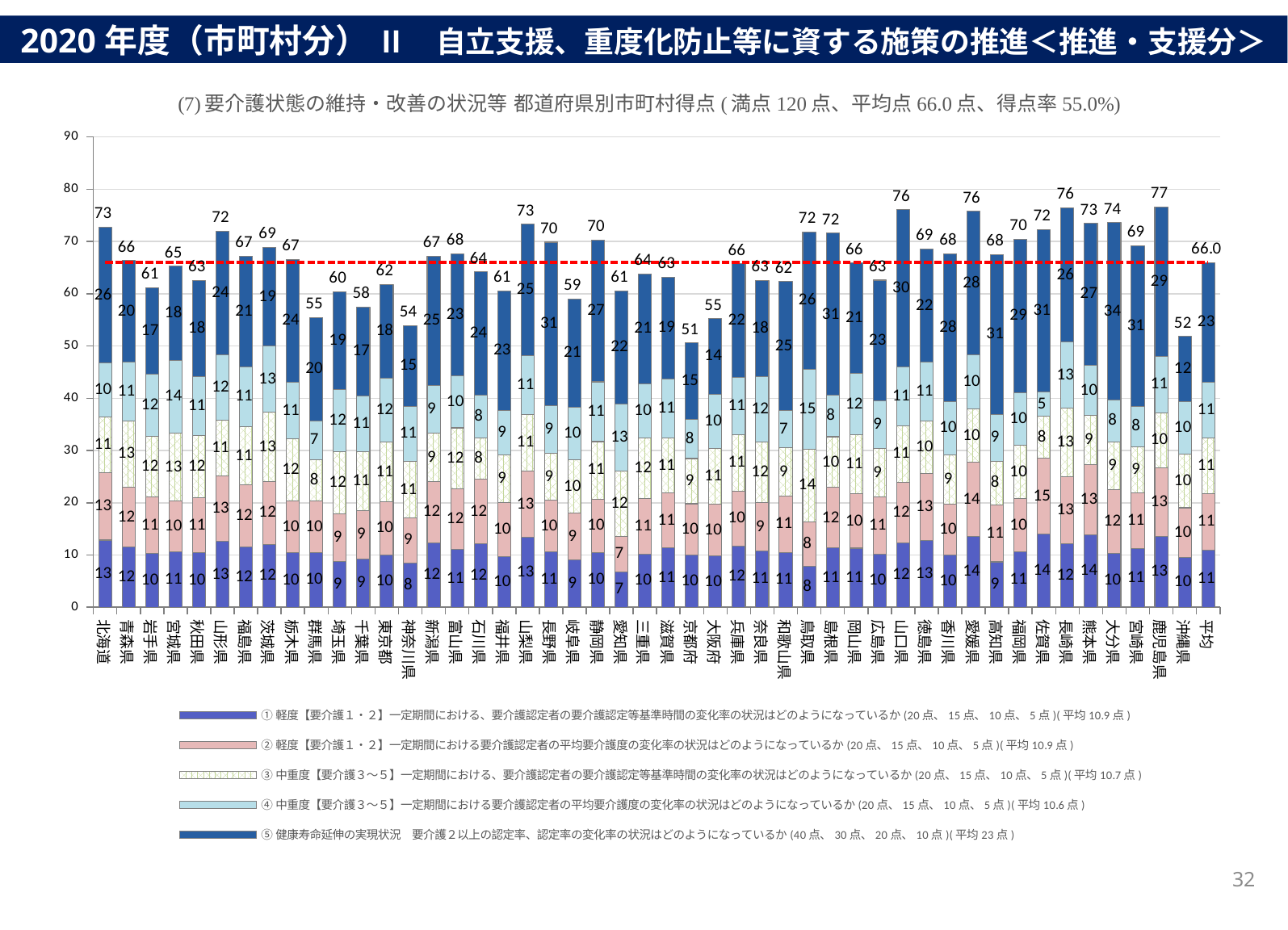
Which prefecture has the lowest total score? 京都府 What value does the red dashed horizontal line mark? 66.0 Is the total score for 神奈川県 greater or less than 60? less What is the value of the top (⑤ 健康寿命延伸) segment for 北海道? 26 What is the total score for 沖縄県? 52 What is the total score for 北海道? 73 What is the difference between the total score of 鹿児島県 and that of 京都府? 26 How many series does the legend list? 5 Which prefecture has the highest total score? 鹿児島県 What kind of chart is shown on the slide? stacked bar chart What is the total score shown for 平均? 66.0 Which has a higher total score, 山口県 or 群馬県? 山口県